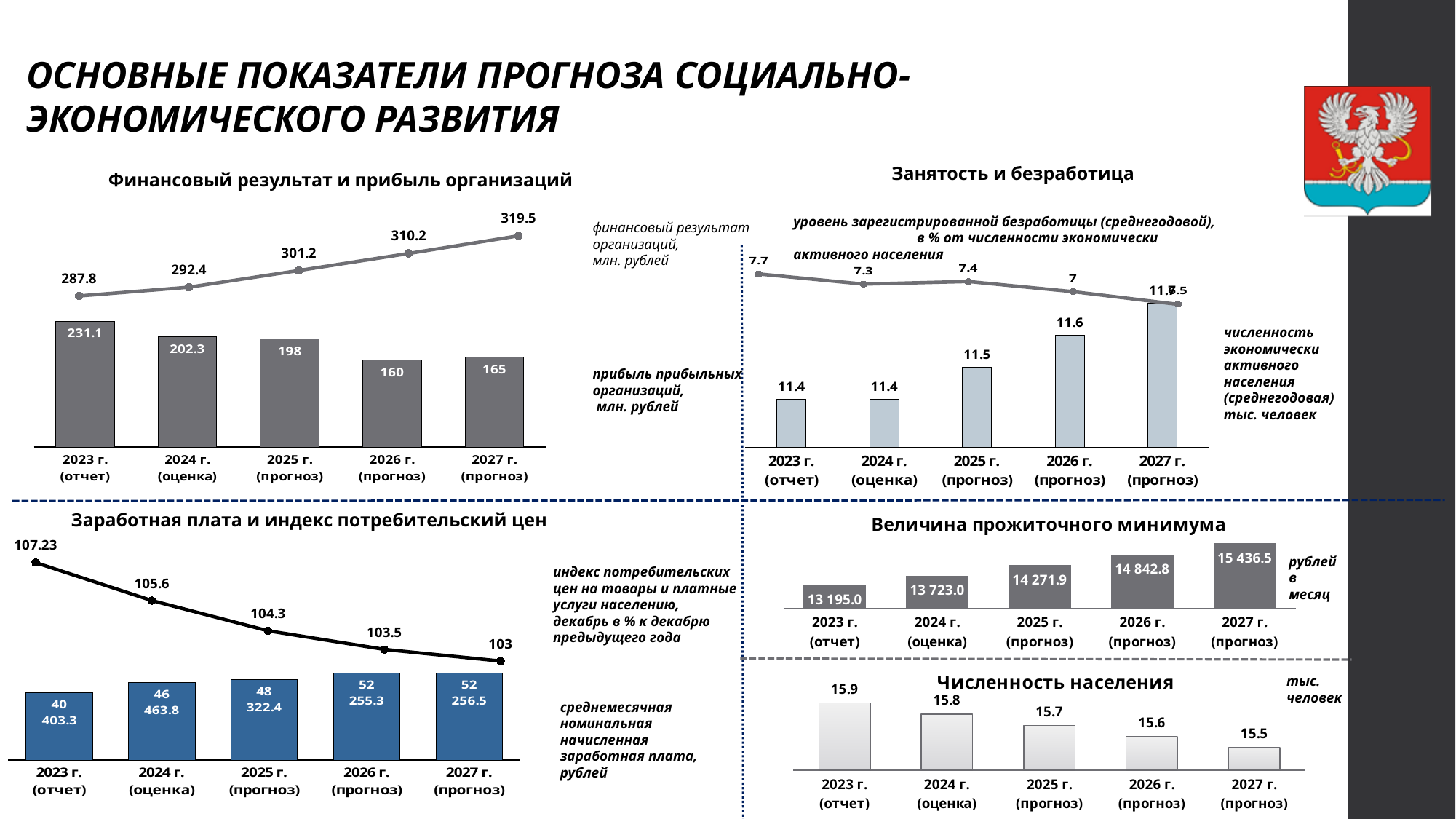
In the chart 'Занятость и безработица', what is the bar value (численность экономически активного населения) for 2026 г. (прогноз)? 11.6 In the chart 'Заработная плата и индекс потребительский цен', what is the consumer price index value for 2023 г. (отчет)? 107.23 In the chart 'Занятость и безработица', what is the registered unemployment rate (line) for 2023 г. (отчет)? 7.7 In the chart 'Величина прожиточного минимума', what is the value for 2027 г. (прогноз)? 15 436.5 How many years (categories) are shown in the chart 'Численность населения'? 5 In the chart 'Заработная плата и индекс потребительский цен', does the consumer price index line rise or fall from 2023 г. to 2027 г.? falls In the chart 'Финансовый результат и прибыль организаций', which year has the highest bar (прибыль прибыльных организаций)? 2023 г. (отчет) In the chart 'Финансовый результат и прибыль организаций', does the line (финансовый результат) rise or fall from 2023 г. to 2027 г.? rises In the chart 'Финансовый результат и прибыль организаций', what is the difference between the bar values for 2023 г. and 2024 г.? 28.8 In the chart 'Финансовый результат и прибыль организаций', what is the value of the line (финансовый результат) for 2027 г. (прогноз)? 319.5 In the chart 'Заработная плата и индекс потребительский цен', what is the average monthly wage for 2025 г. (прогноз)? 48 322.4 In the chart 'Численность населения', which year has the lowest value? 2027 г. (прогноз)